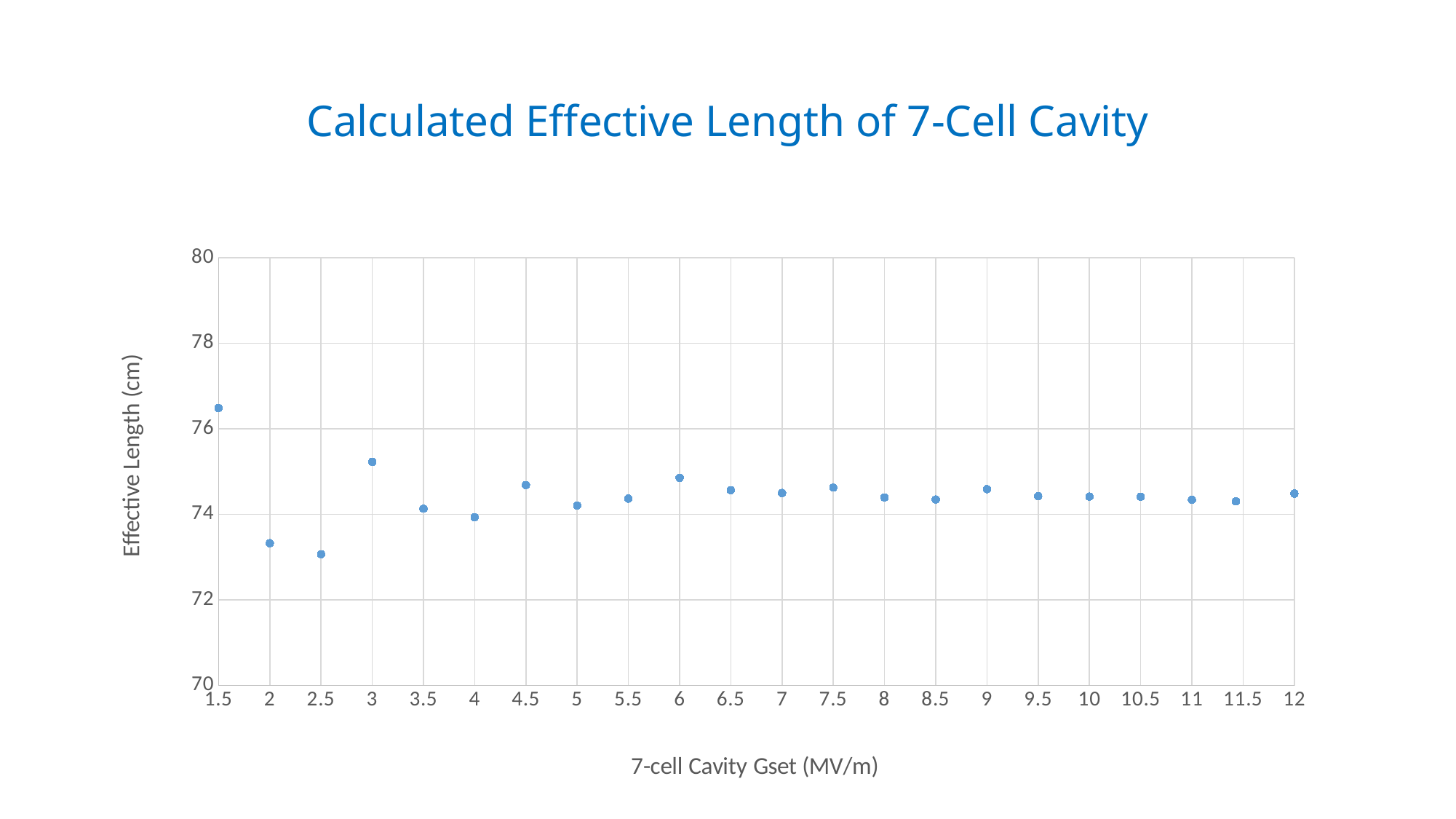
How many data points are plotted on the chart? 22 Is the effective length at Gset 3 greater or less than 75? greater Which has the larger effective length, Gset 3 or Gset 4? Gset 3 What is the title of the chart? Calculated Effective Length of 7-Cell Cavity Is the effective length at Gset 1.5 greater or less than 76? greater What type of chart is shown on the slide? Scatter chart At which Gset value is the effective length highest? 1.5 Is the effective length at Gset 2.5 greater or less than 74? less At which Gset value is the effective length lowest? 2.5 What is the label of the vertical axis? Effective Length (cm) Which has the larger effective length, Gset 2 or Gset 6? Gset 6